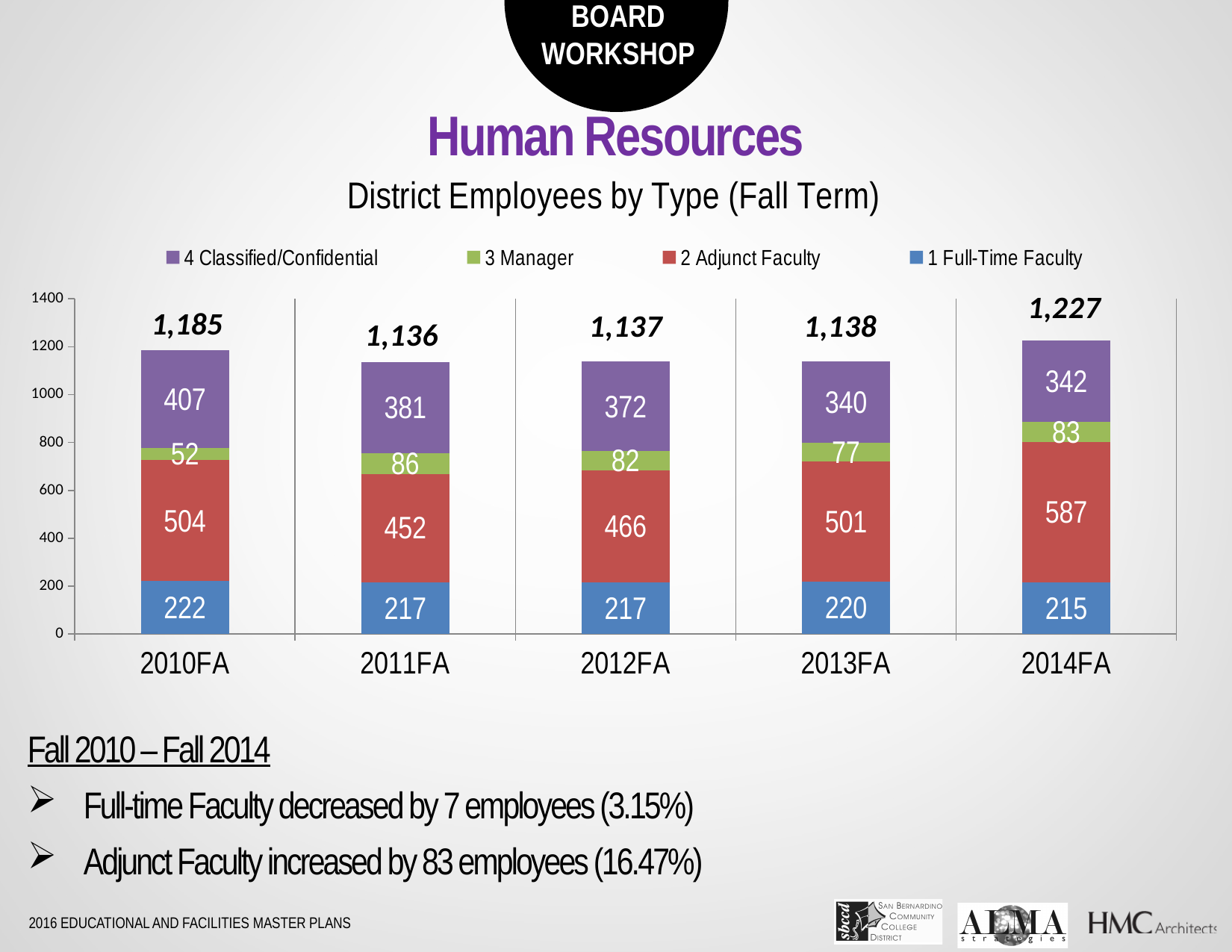
Which fall term has the highest total number of district employees? 2014FA Which fall term has the lowest total number of district employees? 2011FA How many fall terms are shown on the x axis? 5 What is the value for 4 Classified/Confidential in 2010FA? 407 What is the value for 3 Manager in 2013FA? 77 What is the total of the stacked bar for 2014FA? 1,227 What is the title of the chart? District Employees by Type (Fall Term) Which is larger: the 3 Manager value in 2011FA or in 2012FA? 2011FA What is the value for 2 Adjunct Faculty in 2014FA? 587 How many series does the legend list? 4 What is the difference between the 2 Adjunct Faculty values in 2014FA and 2010FA? 83 What kind of chart is shown on the slide? Stacked bar chart